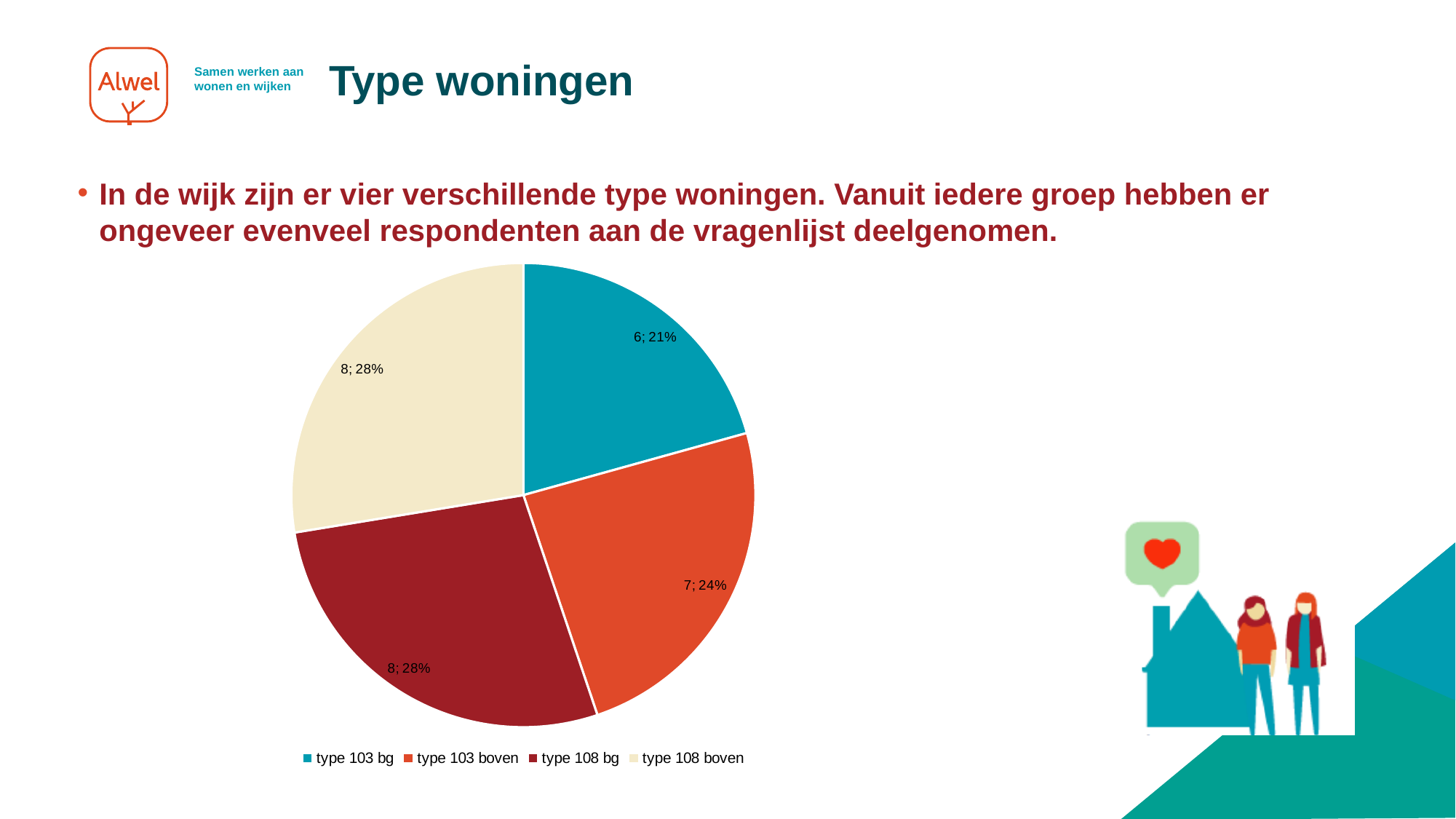
Which category has the smallest slice in the pie chart? type 103 bg What percentage share does type 108 bg have in the pie chart? 28% What is the difference between the counts for type 108 bg and type 103 bg in the pie chart? 2 What colour is the slice for type 108 boven in the pie chart? cream What kind of chart is shown on the slide? pie chart How many slices does the pie chart have? 4 Which is larger in the pie chart: type 103 boven or type 103 bg? type 103 boven What is the count shown for type 103 bg in the pie chart? 6 What is the count shown for type 108 boven in the pie chart? 8 What is the total count across all four slices of the pie chart? 29 How many entries does the legend of the pie chart list? 4 What percentage share does type 103 boven have in the pie chart? 24%